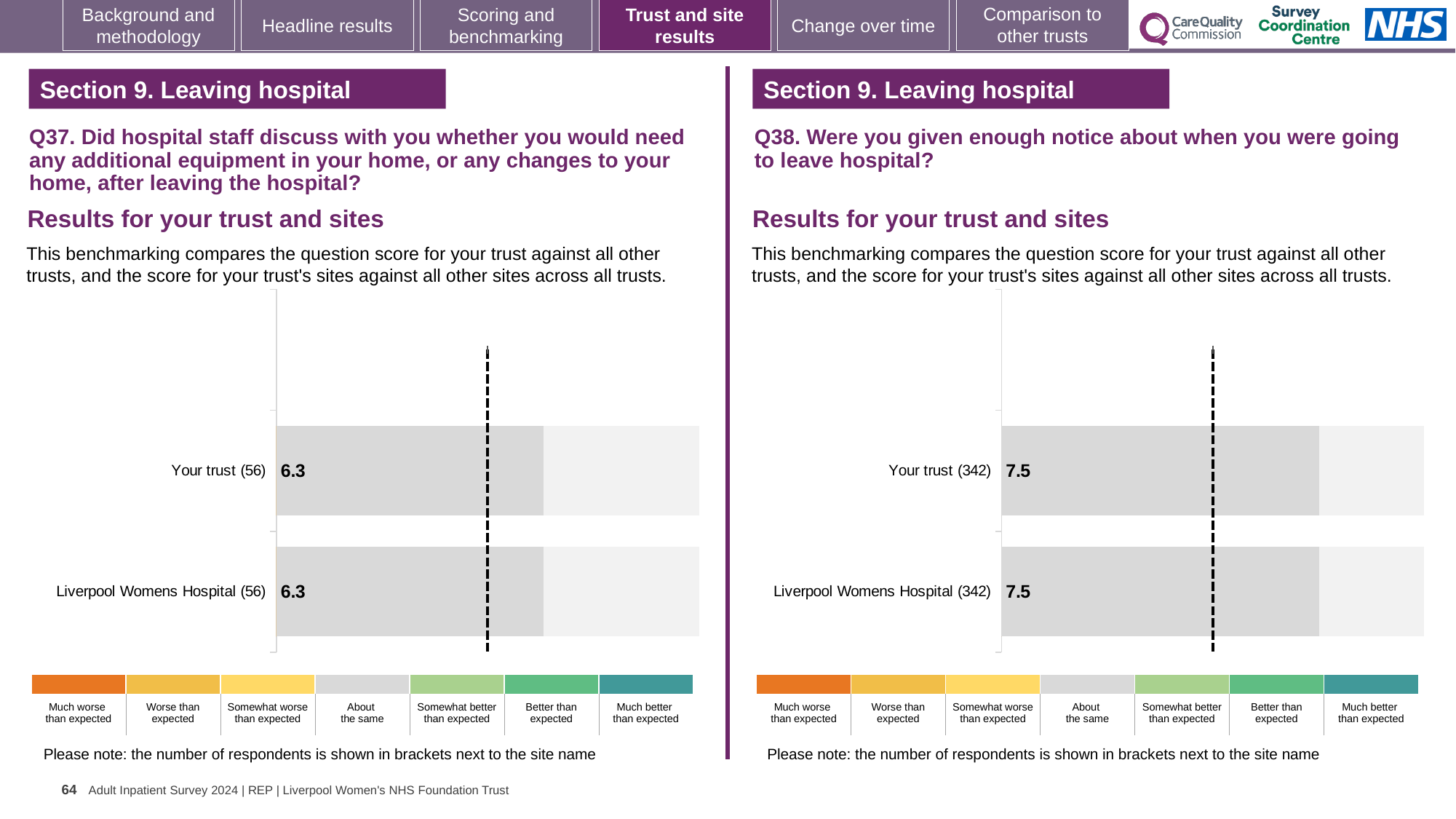
In the Q37 chart on the left, which benchmark category does the grey colour of the bars correspond to in the legend? About the same In the Q37 chart on the left, what is the difference between the Your trust score and the Liverpool Womens Hospital score? 0 In the Q38 chart on the right, what is the score for Liverpool Womens Hospital? 7.5 In the Q37 chart on the left, what is the score for Your trust? 6.3 In the Q37 chart on the left, how many respondents are shown in brackets for Your trust? 56 In the Q38 chart on the right, how many respondents are shown in brackets for Liverpool Womens Hospital? 342 In the Q38 chart on the right, what is the score for Your trust? 7.5 In the Q38 chart on the right, what is the difference between the Your trust score and the Liverpool Womens Hospital score? 0 What kind of chart is used for the Q38 results on the right? Bar chart How many bars are plotted in the Q38 chart on the right? 2 In the Q37 chart on the left, what is the score for Liverpool Womens Hospital? 6.3 How many bars are plotted in the Q37 chart on the left? 2